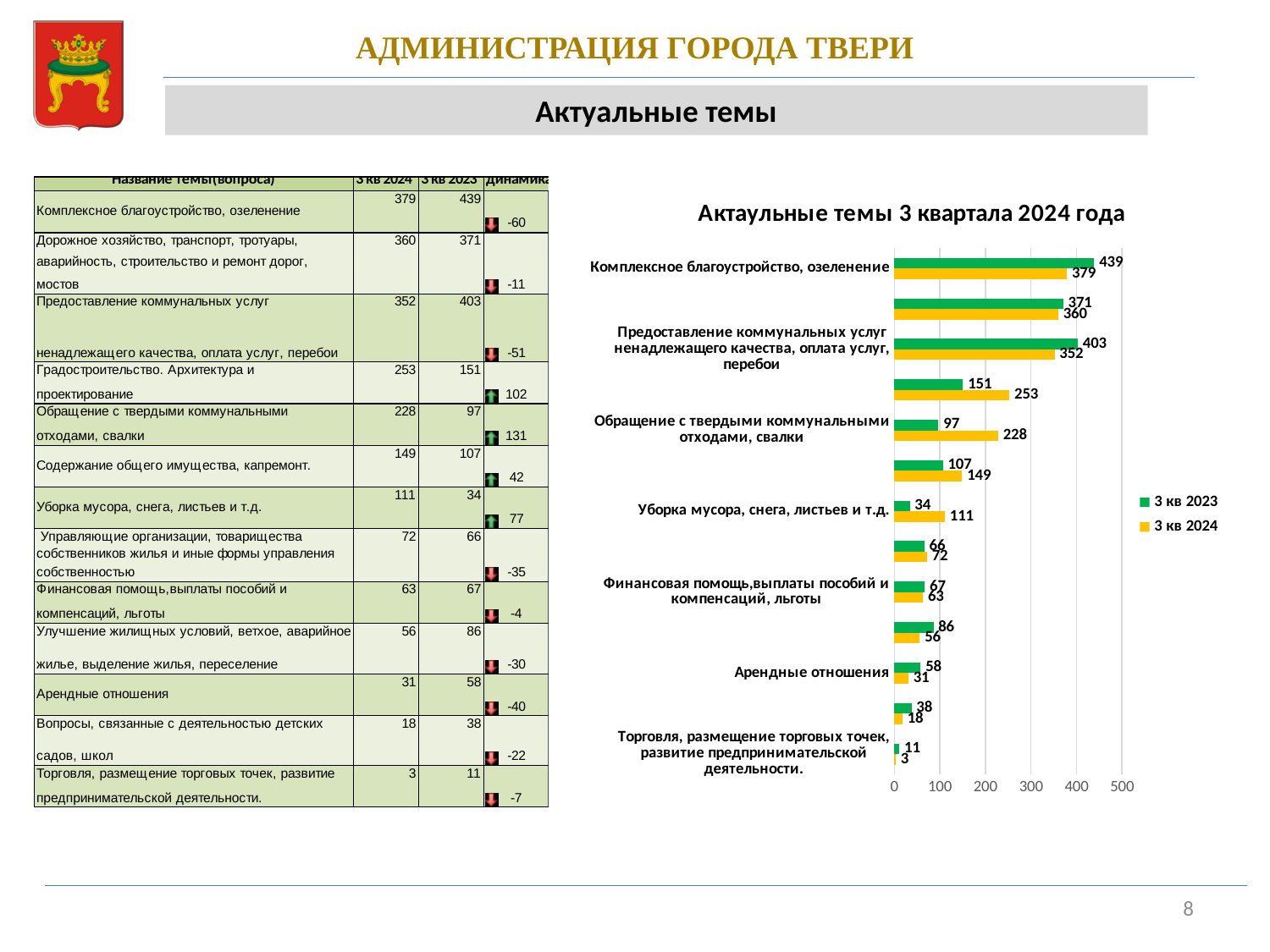
What is the value for 3 кв 2024 for Комплексное благоустройство, озеленение? 379 How many series does the chart legend list? 2 How many categories (bar pairs) are plotted on the chart? 13 What is the title of the chart? Актаульные темы 3 квартала 2024 года What is the difference between the 3 кв 2023 and 3 кв 2024 values for Арендные отношения? 27 What is the value for 3 кв 2024 for Уборка мусора, снега, листьев и т.д.? 111 What type of chart is shown on the slide? bar chart Is the 3 кв 2024 value for Обращение с твердыми коммунальными отходами, свалки greater or less than 200? greater Which category has the lowest value for 3 кв 2024? Торговля, размещение торговых точек, развитие предпринимательской деятельности. Which category has the highest value for 3 кв 2023? Комплексное благоустройство, озеленение For Предоставление коммунальных услуг ненадлежащего качества, оплата услуг, перебои, which is larger: the 3 кв 2023 value or the 3 кв 2024 value? 3 кв 2023 What is the value for 3 кв 2023 for Обращение с твердыми коммунальными отходами, свалки? 97